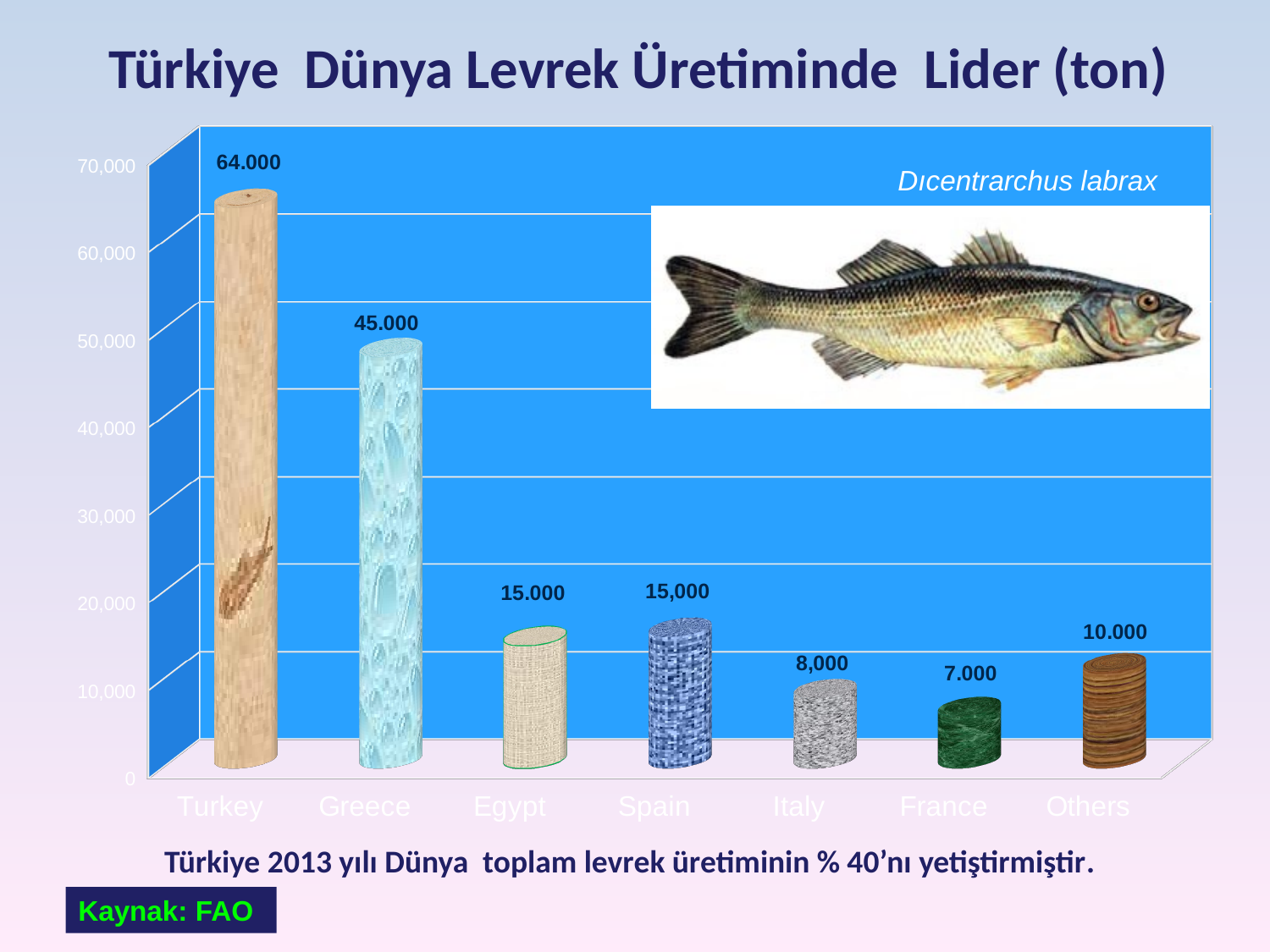
Which category has the lowest value? France Is the value for Greece greater or less than 40,000? greater What is the value for Greece? 45.000 What is the difference between the values for Turkey and Greece? 19.000 Which category has the highest value? Turkey How many categories are shown on the x axis? 7 Which is larger, the value for Italy or the value for Others? Others What kind of chart is shown on the slide? bar chart What is the value for Others? 10.000 What is the value for Turkey? 64.000 What is the value for France? 7.000 What source is cited for the chart data? FAO